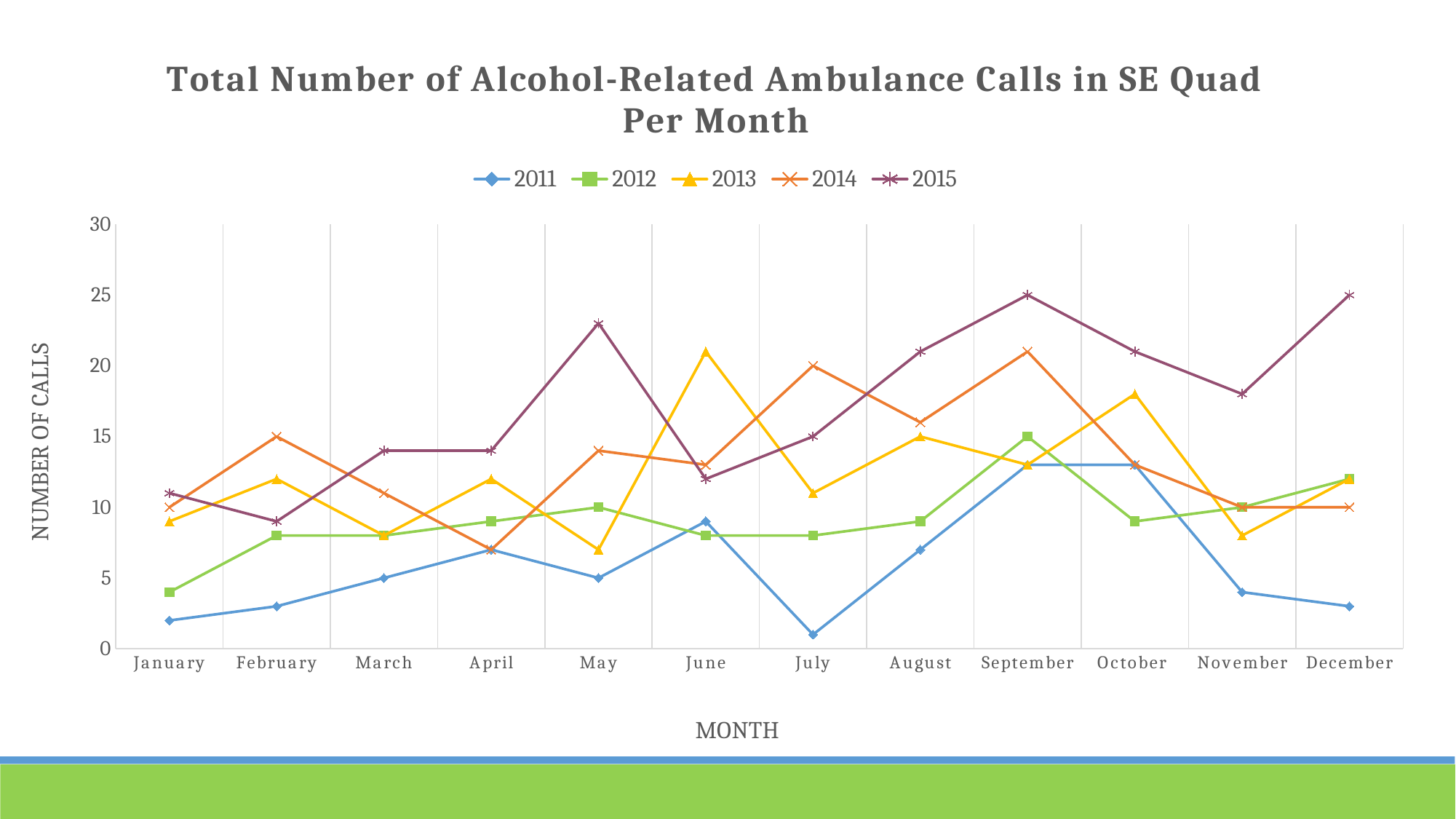
Is the value for 2011 in July greater or less than 5? less What is the value for 2011 in May? 5 What is the value for 2015 in September? 25 What kind of chart is shown on the slide? line chart In June, which is larger: the value for 2013 or the value for 2014? 2013 What is the value for 2014 in July? 20 Which series has the highest value in December? 2015 How many series does the legend list? 5 What is the difference between the 2015 value and the 2014 value in December? 15 How many months are plotted along the x axis? 12 Is the value for 2015 in May greater or less than 20? greater Which series has the lowest value in July? 2011